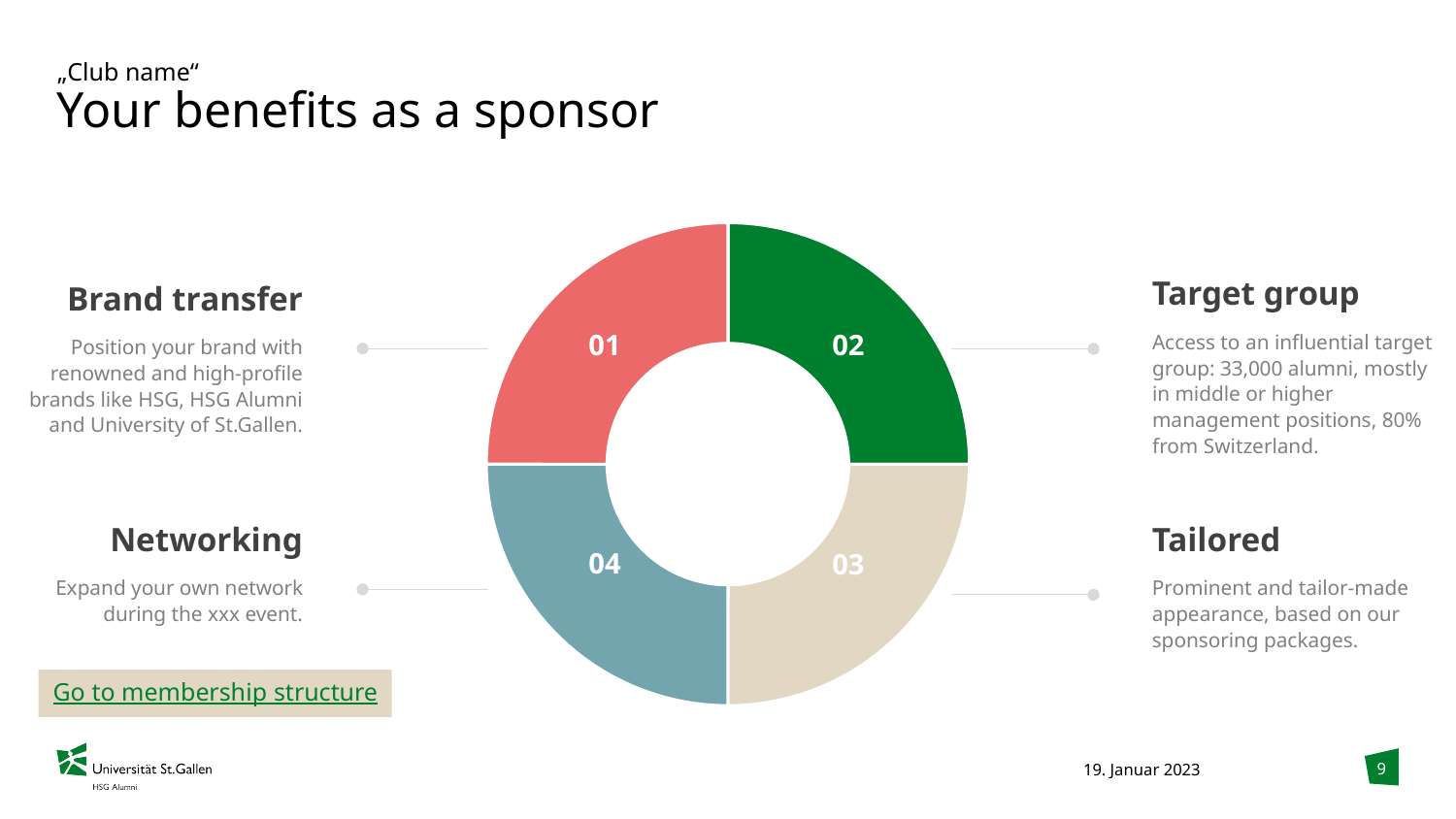
What colour is segment 02 of the doughnut chart? Green What labels are printed on the four segments of the doughnut chart? 01, 02, 03, 04 Which benefit heading is connected to segment 03 of the doughnut chart? Tailored How many segments does the doughnut chart have? 4 Which benefit heading is connected to segment 01 of the doughnut chart? Brand transfer What kind of chart is shown in the centre of the slide? Doughnut (ring) chart